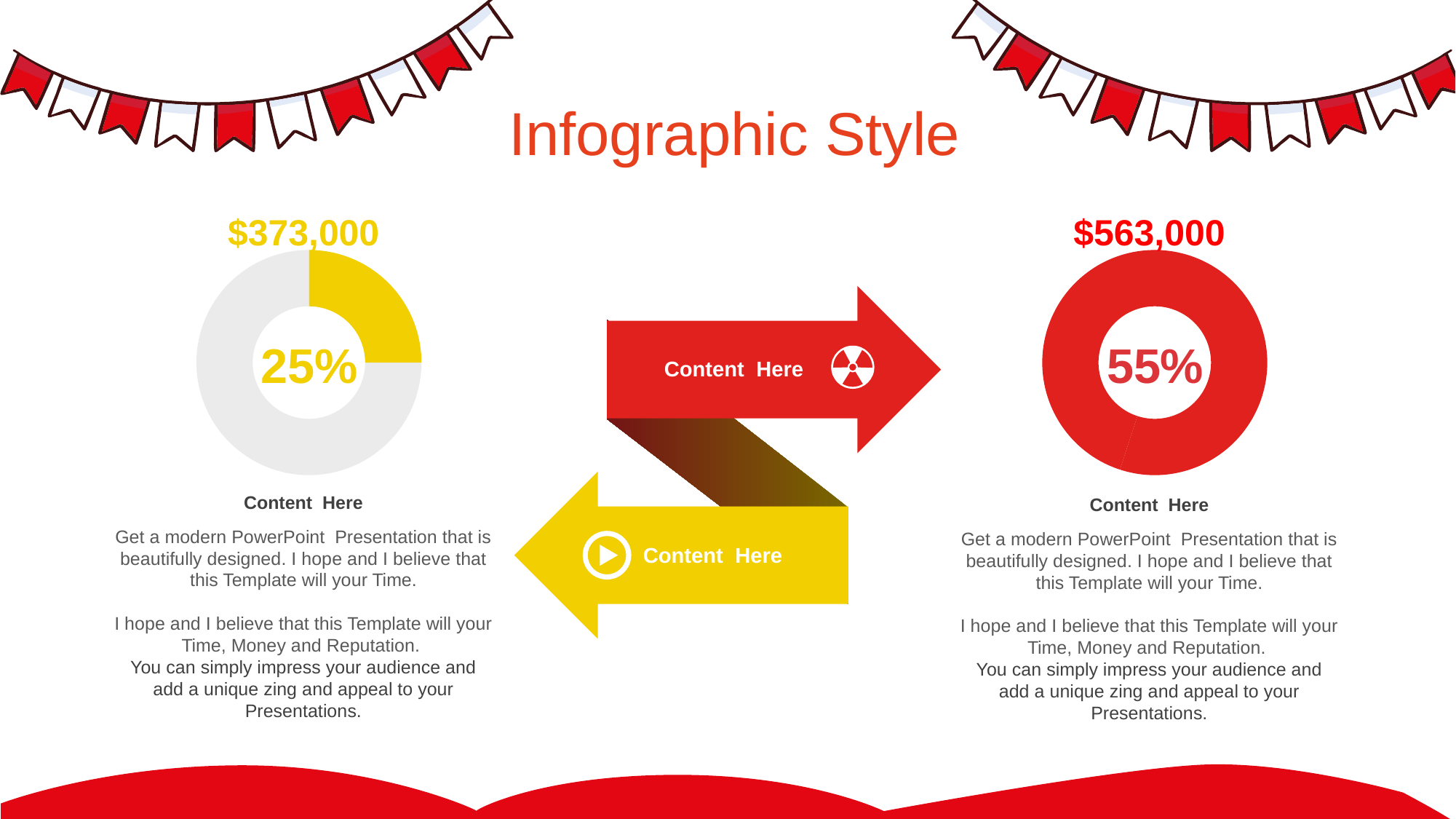
What kind of chart is shown on the right side of the slide? Donut chart What percentage is shown in the centre of the right donut chart? 55% Which donut chart shows the larger percentage, the left one or the right one? The right one What kind of chart is shown on the left side of the slide? Donut chart What dollar amount is printed above the left donut chart? $373,000 What colour is the filled portion of the left donut chart? Yellow What dollar amount is printed above the right donut chart? $563,000 What is the difference between the percentages shown in the right and left donut charts? 30% How many donut charts are on the slide? 2 What percentage is shown in the centre of the left donut chart? 25% What colour is the right donut chart? Red What is the difference between the dollar amounts printed above the right and left donut charts? $190,000